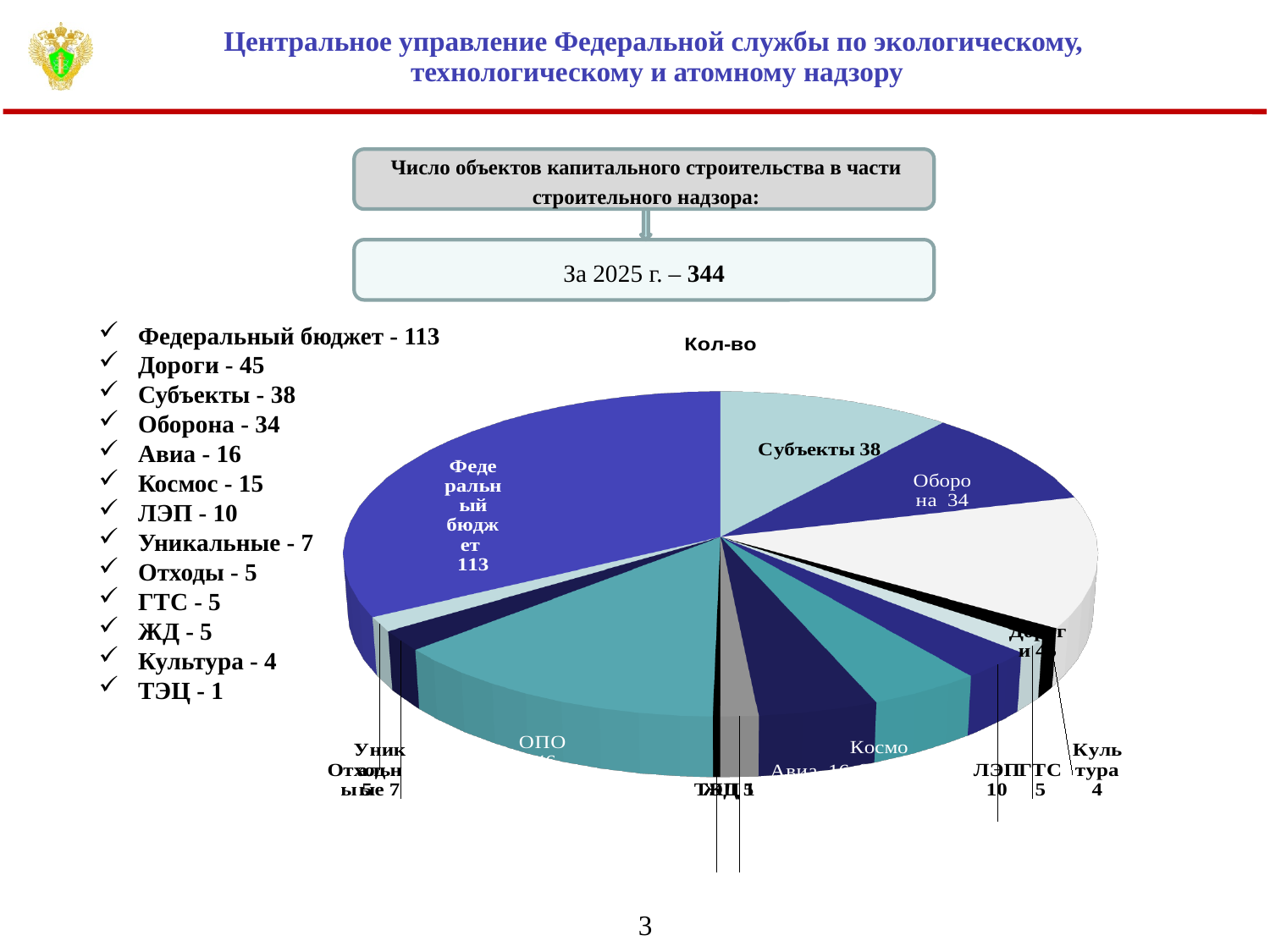
What is the value for ЛЭП in the chart? 10 Which is larger, the value for Авиа or the value for ЛЭП? Авиа What is the value for Федеральный бюджет in the chart? 113 What is the title of the chart? Кол-во Which category has the largest slice in the chart? Федеральный бюджет What kind of chart is shown on the slide? pie chart What is the value for Авиа in the chart? 16 What is the value for Субъекты in the chart? 38 What is the value for Культура in the chart? 4 What is the difference between the values for Субъекты and Оборона? 4 Which category has the smallest slice in the chart? ТЭЦ What is the value for Оборона in the chart? 34